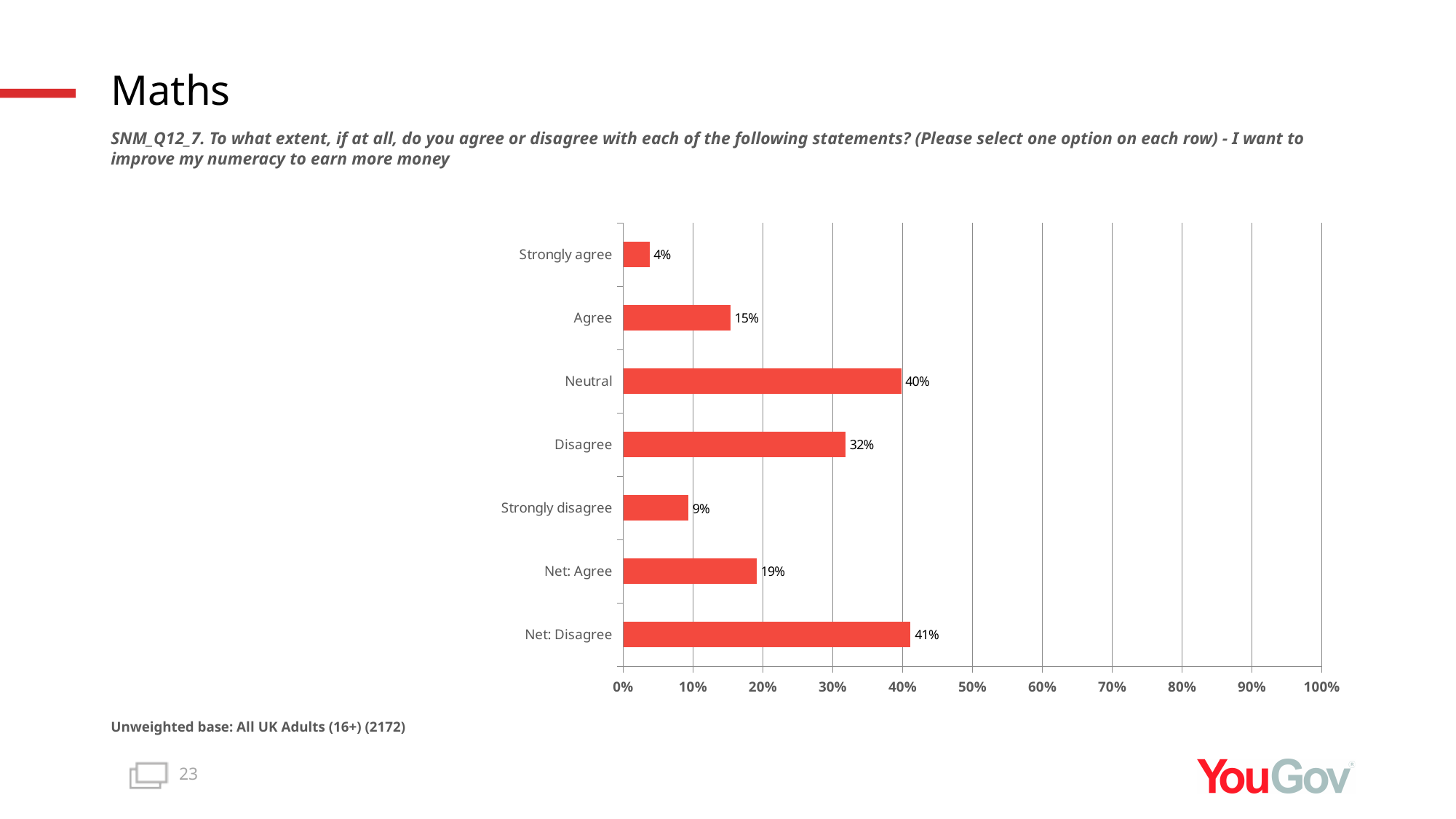
Which category has the lowest value? Strongly agree How many categories are shown on the chart? 7 What is the difference between 'Net: Disagree' and 'Net: Agree'? 22% What is the unweighted base stated below the chart? All UK Adults (16+) (2172) What is the value shown for 'Net: Disagree'? 41% Which is larger, 'Agree' or 'Strongly disagree'? Agree What kind of chart is shown on the slide? Bar chart Is the value for 'Disagree' greater or less than 30%? greater What is the value shown for 'Strongly agree'? 4% What percentage of respondents selected 'Neutral'? 40% Which category has the highest value? Net: Disagree What is the difference between 'Neutral' and 'Disagree'? 8%